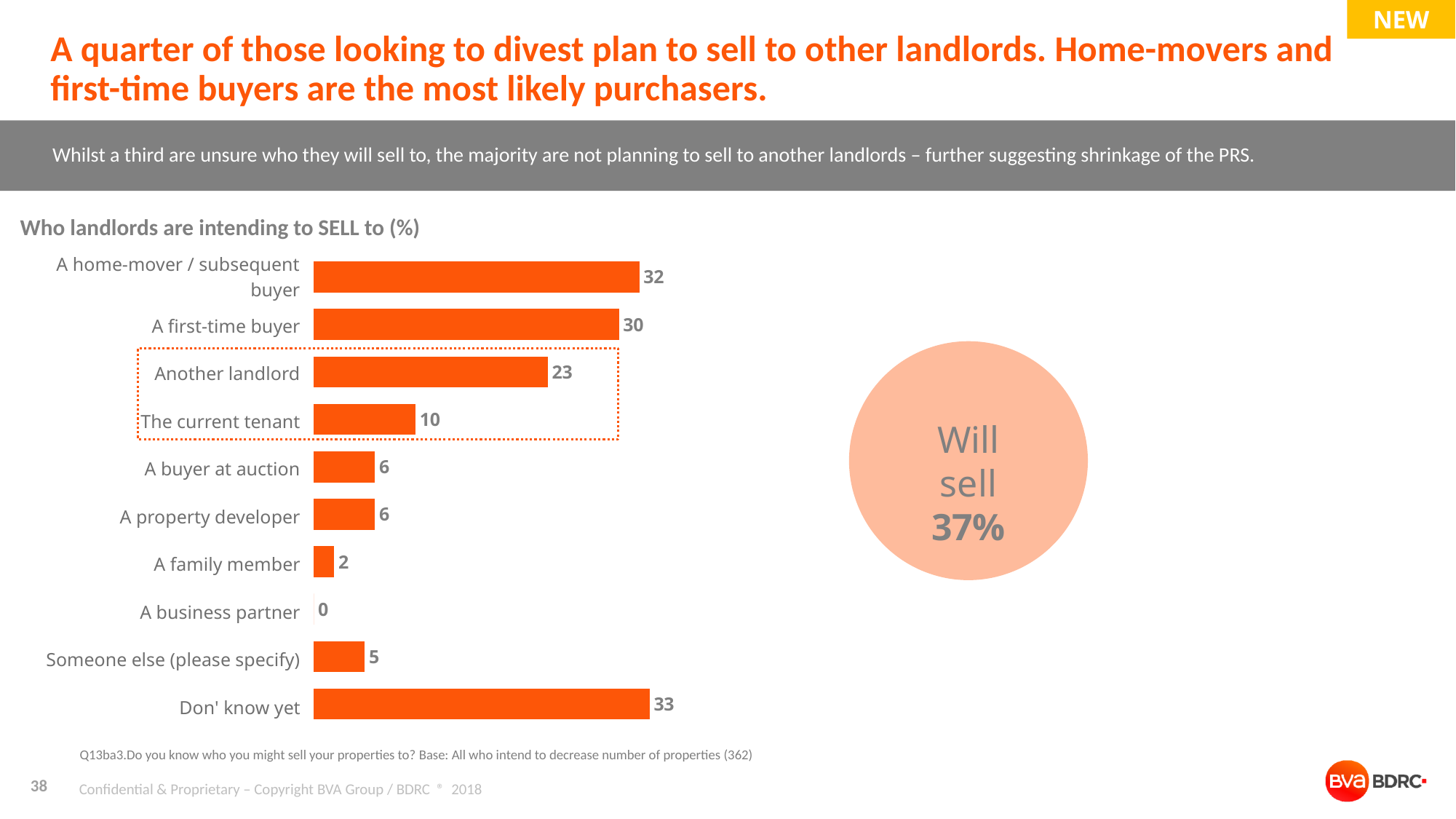
What is the value for 'Another landlord'? 23 Which category has the lowest value? A business partner What percentage is shown in the circle labelled 'Will sell'? 37% What is the value for 'The current tenant'? 10 How many categories are shown in the bar chart? 10 What is the value for 'A home-mover / subsequent buyer'? 32 Which category has the highest value? Don' know yet What is the title of the chart? Who landlords are intending to SELL to (%) What kind of chart is used to show who landlords are intending to sell to? Bar chart What is the value for 'A business partner'? 0 Which is larger, 'A first-time buyer' or 'Another landlord'? A first-time buyer What is the difference between 'A home-mover / subsequent buyer' and 'A first-time buyer'? 2